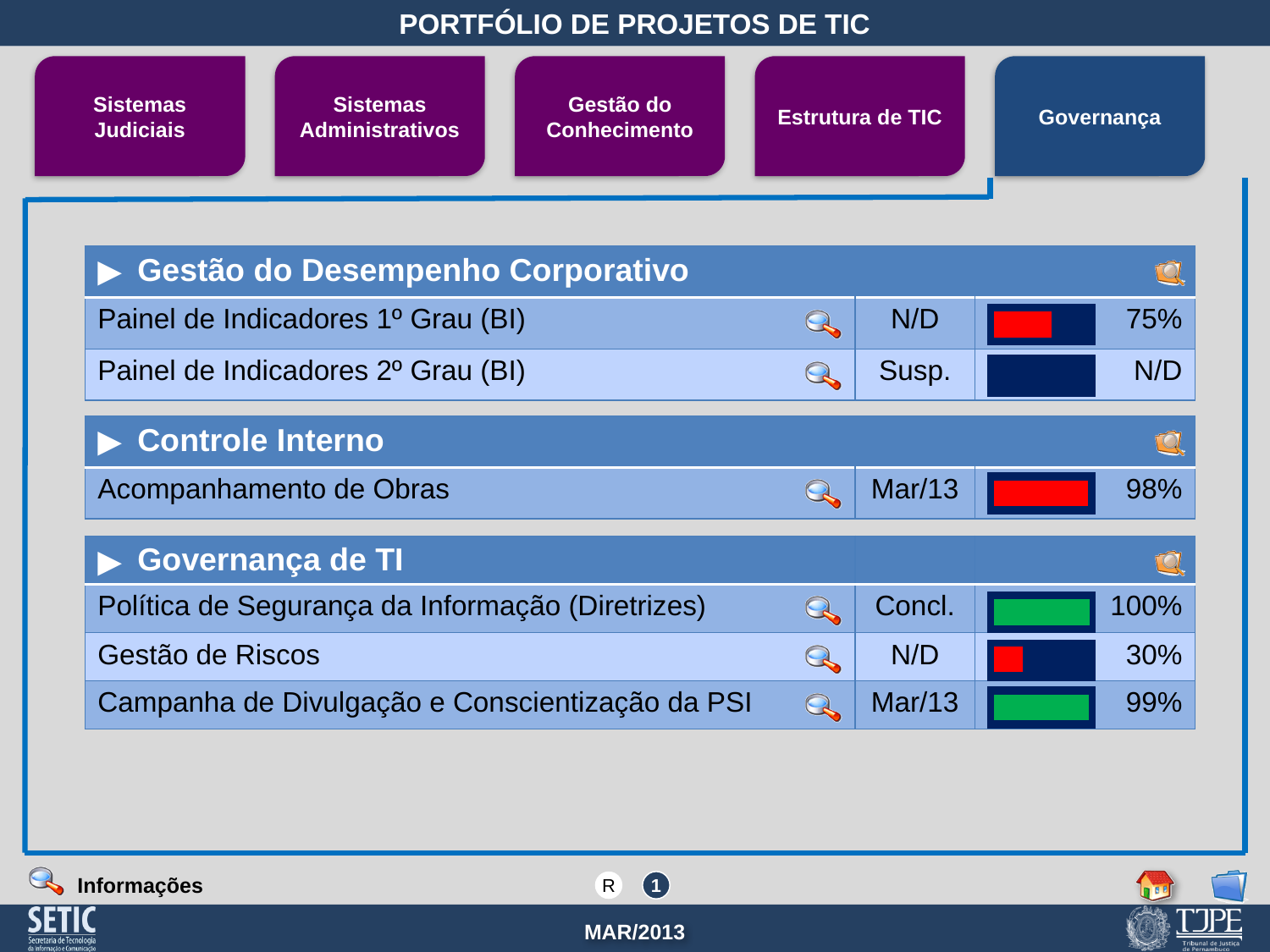
What progress percentage is shown for Gestão de Riscos? 30% What colour is the filled portion of the progress bar for Gestão de Riscos? Red Among the projects with a percentage shown, which has the lowest progress? Gestão de Riscos What progress percentage is shown for Painel de Indicadores 1º Grau (BI)? 75% How many projects are listed with progress bars on the slide? 6 Which project has the highest progress percentage? Política de Segurança da Informação (Diretrizes) Which has a higher progress percentage, Painel de Indicadores 1º Grau (BI) or Gestão de Riscos? Painel de Indicadores 1º Grau (BI) What progress percentage is shown for Campanha de Divulgação e Conscientização da PSI? 99% What progress percentage is shown for Acompanhamento de Obras? 98% What is the difference in progress between Acompanhamento de Obras and Gestão de Riscos? 68 percentage points What progress percentage is shown for Política de Segurança da Informação (Diretrizes)? 100% What status is shown in the date column for Painel de Indicadores 2º Grau (BI)? Susp.